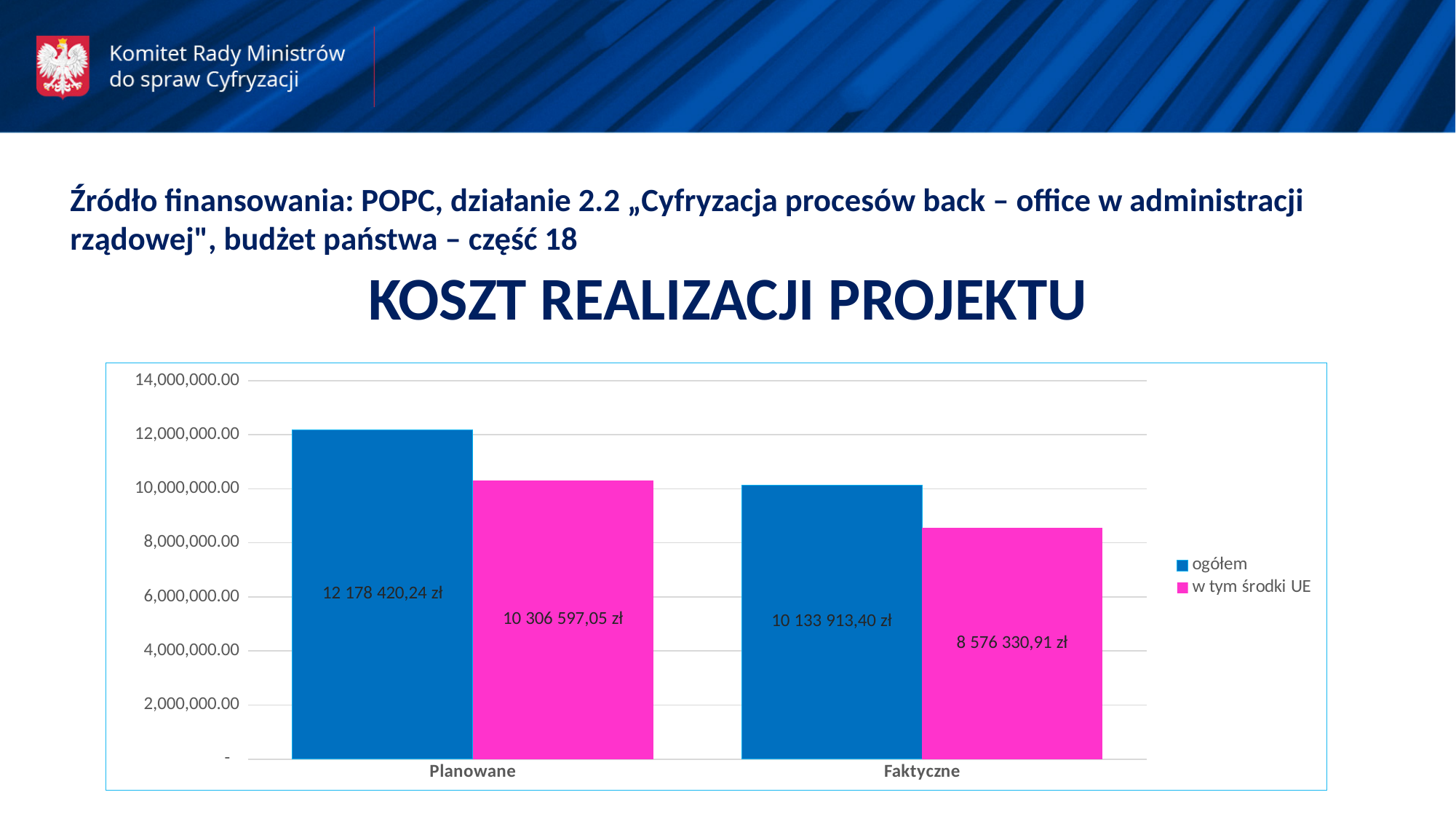
What type of chart is shown on the slide? bar chart What is the difference between the "ogółem" values for Planowane and Faktyczne? 2 044 506,84 zł What is the value of "ogółem" for Faktyczne? 10 133 913,40 zł Is the "ogółem" value for Faktyczne greater or less than 12,000,000.00? less Which bar has the highest value in the chart? Planowane, ogółem Which bar has the lowest value in the chart? Faktyczne, w tym środki UE What is the value of "w tym środki UE" for Planowane? 10 306 597,05 zł What is the difference between "ogółem" and "w tym środki UE" for Planowane? 1 871 823,19 zł How many series does the legend list? 2 What is the value of "ogółem" for Planowane? 12 178 420,24 zł What is the value of "w tym środki UE" for Faktyczne? 8 576 330,91 zł Which is larger: "w tym środki UE" for Planowane or "ogółem" for Faktyczne? w tym środki UE for Planowane